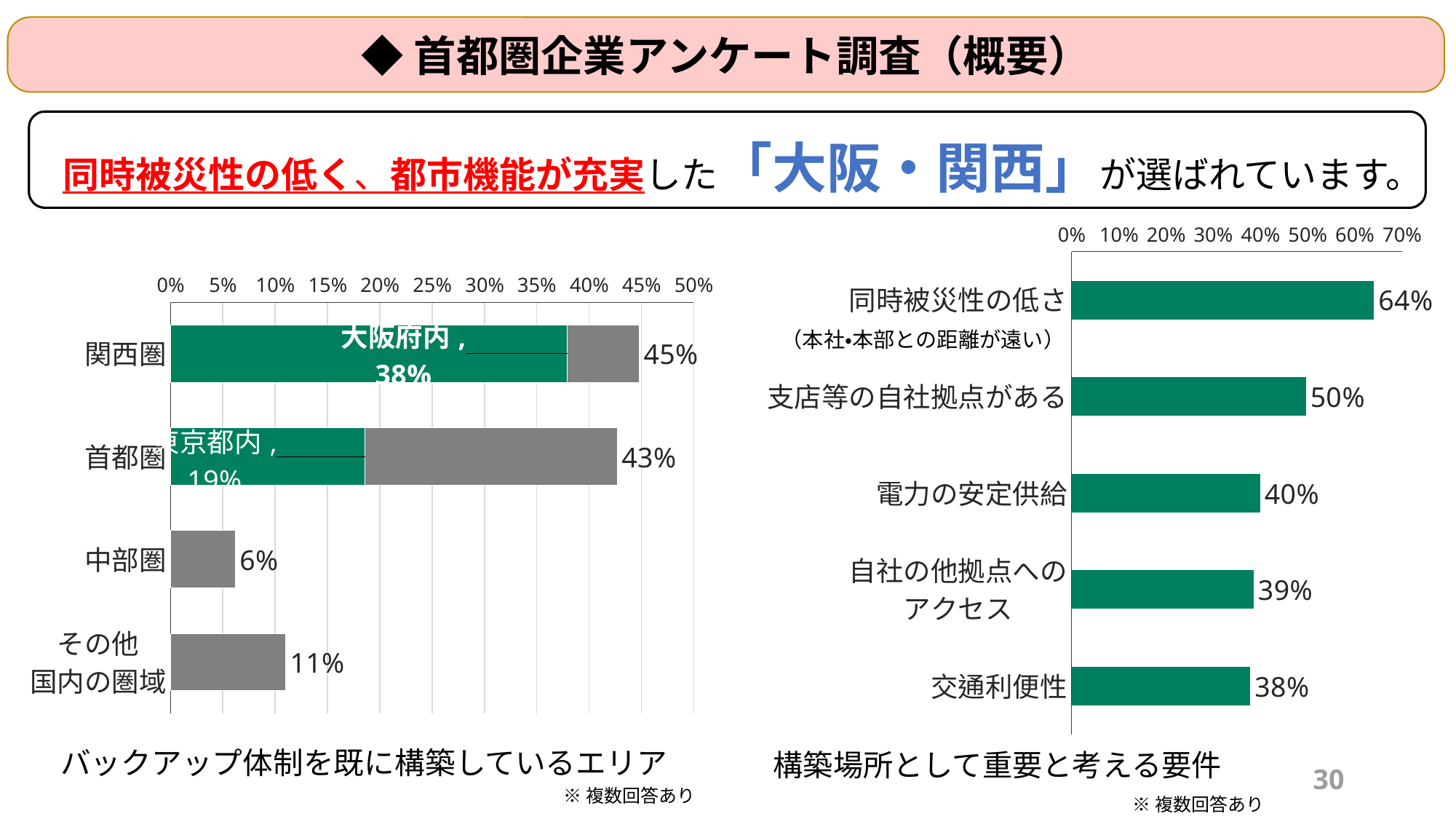
In the chart titled 構築場所として重要と考える要件, what is the value for 同時被災性の低さ? 64% In the chart titled 構築場所として重要と考える要件, what is the value for 交通利便性? 38% In the chart titled 構築場所として重要と考える要件, what is the difference between 同時被災性の低さ and 支店等の自社拠点がある? 14% In the chart titled バックアップ体制を既に構築しているエリア, what value is labelled for 大阪府内 within the 関西圏 bar? 38% What kind of chart is the chart titled 構築場所として重要と考える要件? Bar chart In the chart titled 構築場所として重要と考える要件, how many categories are shown? 5 In the chart titled バックアップ体制を既に構築しているエリア, what is the difference between 関西圏 and 首都圏? 2% In the chart titled バックアップ体制を既に構築しているエリア, what is the value for 中部圏? 6% In the chart titled バックアップ体制を既に構築しているエリア, which category has the lowest value? 中部圏 In the chart titled バックアップ体制を既に構築しているエリア, what is the value for 関西圏? 45% In the chart titled バックアップ体制を既に構築しているエリア, how many categories are shown? 4 In the chart titled 構築場所として重要と考える要件, which category has the highest value? 同時被災性の低さ